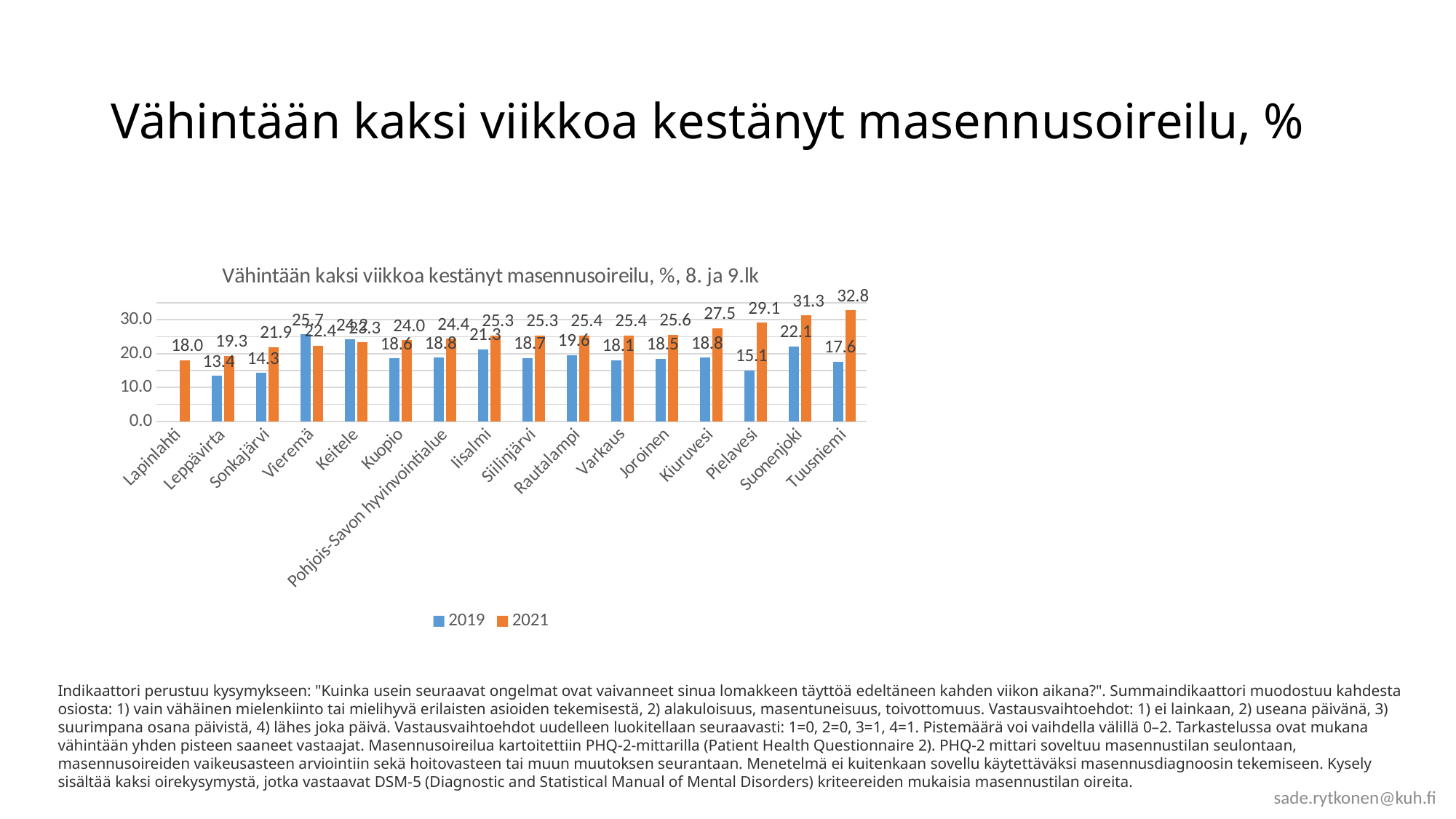
How many municipalities/categories are shown on the x axis? 16 What is the 2021 value for Tuusniemi? 32.8 What is the title of the chart? Vähintään kaksi viikkoa kestänyt masennusoireilu, %, 8. ja 9.lk What is the 2021 value for Kuopio? 24.0 Is the 2021 value for Pielavesi greater or less than 20.0? greater What is the difference between the 2021 and 2019 values for Suonenjoki? 9.2 Which category has the highest 2021 value? Tuusniemi What type of chart is shown on the slide? bar chart What is the 2019 value for Pielavesi? 15.1 Which category has the lowest 2019 value? Leppävirta Which is larger for Vieremä, the 2019 value or the 2021 value? 2019 How many series does the legend list? 2